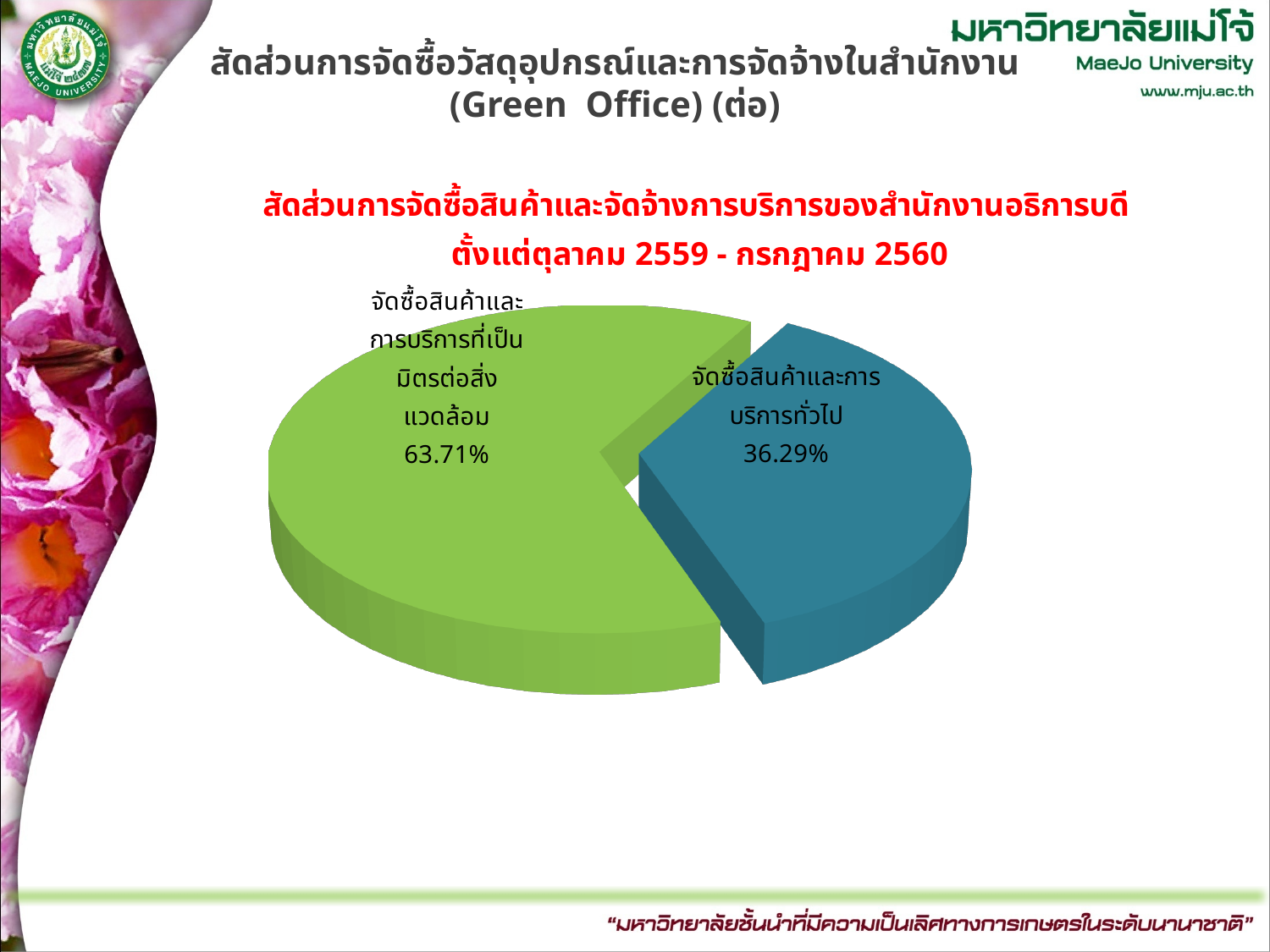
How many slices does the pie chart have? 2 What is the difference in percentage points between the environmentally friendly purchases slice and the general purchases slice? 27.42 What kind of chart is shown on the slide? Pie chart What colour is the slice representing จัดซื้อสินค้าและการบริการทั่วไป? Blue Which slice of the pie chart is the largest? จัดซื้อสินค้าและการบริการที่เป็นมิตรต่อสิ่งแวดล้อม Which is larger: the share for จัดซื้อสินค้าและการบริการทั่วไป or the share for จัดซื้อสินค้าและการบริการที่เป็นมิตรต่อสิ่งแวดล้อม? จัดซื้อสินค้าและการบริการที่เป็นมิตรต่อสิ่งแวดล้อม What period does the chart title say the data covers? ตุลาคม 2559 - กรกฎาคม 2560 Which slice of the pie chart is the smallest? จัดซื้อสินค้าและการบริการทั่วไป What share of the pie is labelled จัดซื้อสินค้าและการบริการที่เป็นมิตรต่อสิ่งแวดล้อม? 63.71% What is the combined share of the two slices in the pie chart? 100% What share of the pie is labelled จัดซื้อสินค้าและการบริการทั่วไป? 36.29%